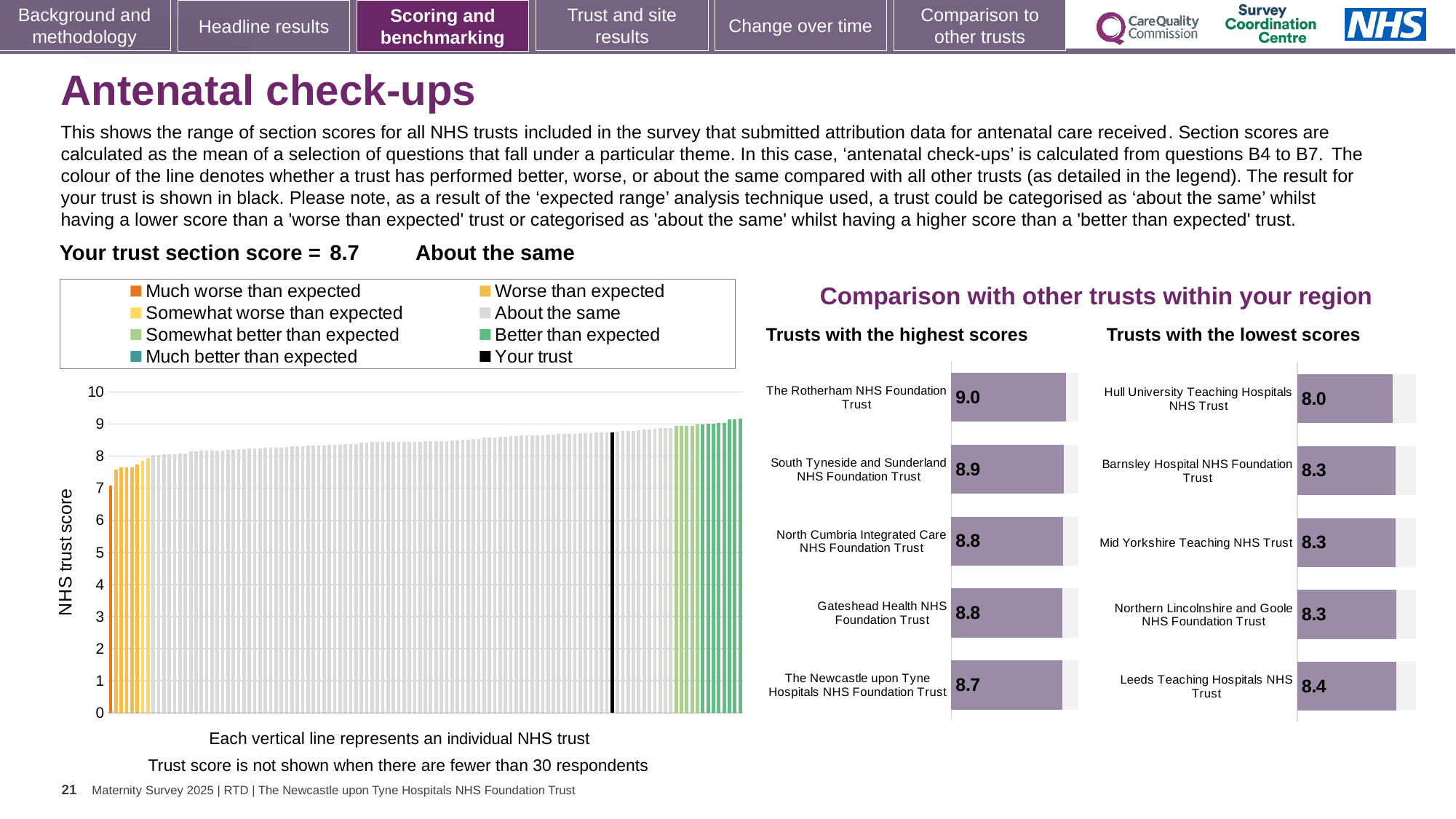
In the 'Trusts with the highest scores' chart, what is the score for South Tyneside and Sunderland NHS Foundation Trust? 8.9 In the 'Trusts with the lowest scores' chart, what is the score for Leeds Teaching Hospitals NHS Trust? 8.4 In the 'Trusts with the lowest scores' chart, which has the larger score: Leeds Teaching Hospitals NHS Trust or Hull University Teaching Hospitals NHS Trust? Leeds Teaching Hospitals NHS Trust In the 'Trusts with the highest scores' chart, what is the score for The Rotherham NHS Foundation Trust? 9.0 What kind of chart is the NHS trust score chart on the left of the slide? Bar chart How many trusts are shown in the 'Trusts with the highest scores' chart? 5 In the 'Trusts with the lowest scores' chart, what is the score for Hull University Teaching Hospitals NHS Trust? 8.0 In the NHS trust score chart on the left, do the bar values rise or fall from left to right? Rise In the 'Trusts with the highest scores' chart, which trust has the highest score? The Rotherham NHS Foundation Trust In the 'Trusts with the lowest scores' chart, which trust has the lowest score? Hull University Teaching Hospitals NHS Trust How many entries does the legend of the NHS trust score chart list? 8 In the 'Trusts with the highest scores' chart, what is the difference between the scores of The Rotherham NHS Foundation Trust and The Newcastle upon Tyne Hospitals NHS Foundation Trust? 0.3